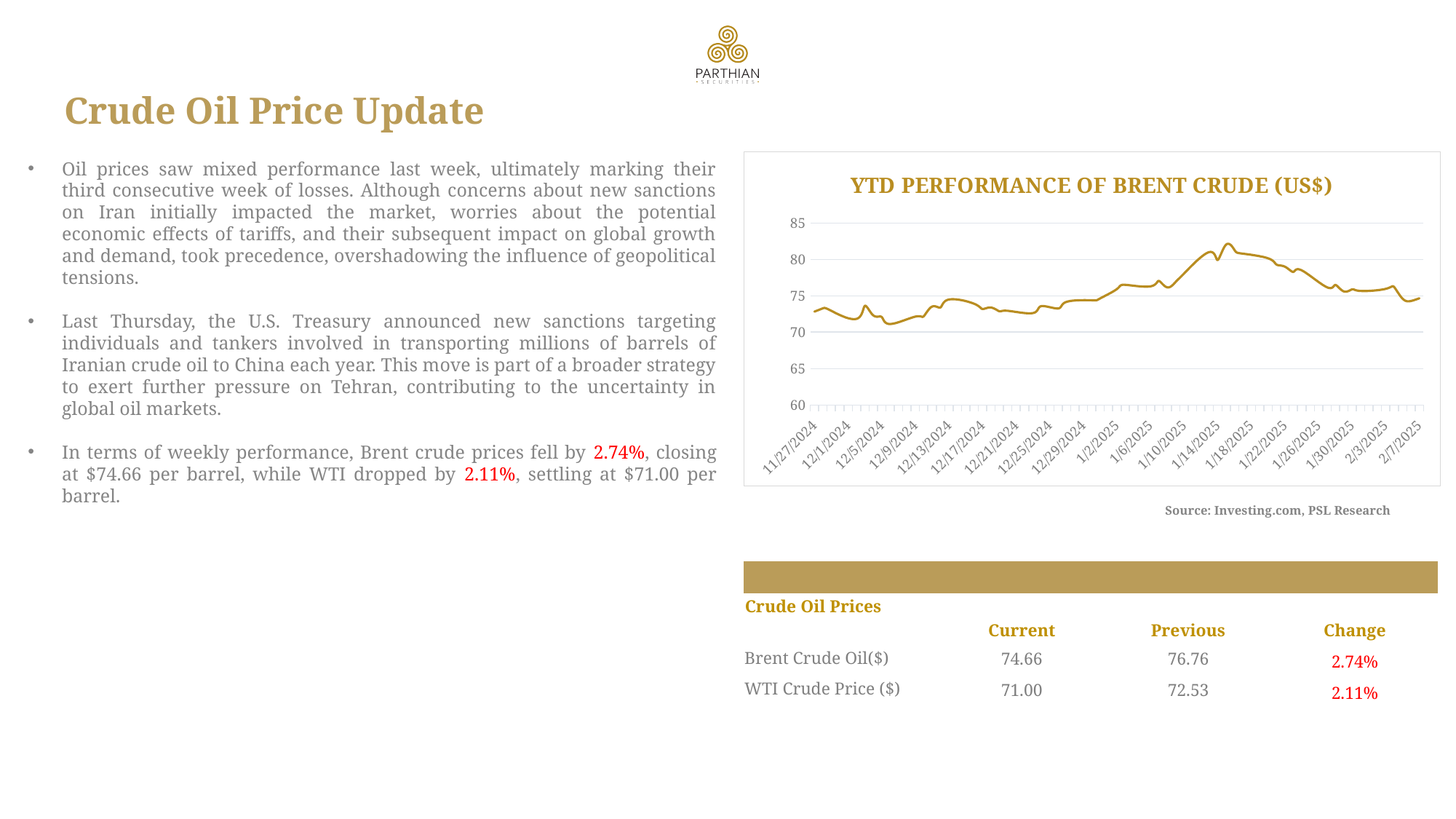
In the YTD Performance of Brent Crude chart, is the value around 1/14/2025 larger or smaller than the value at 12/5/2024? larger What is the title of the chart on the slide? YTD PERFORMANCE OF BRENT CRUDE (US$) What are the lowest and highest values shown on the y axis of the YTD Performance of Brent Crude chart? 60 and 85 In the YTD Performance of Brent Crude chart, is the value at 1/22/2025 greater or less than 75? greater What kind of chart is shown on the slide? line chart In the YTD Performance of Brent Crude chart, does the line rise or fall between 12/25/2024 and 1/14/2025? rise In the YTD Performance of Brent Crude chart, in which month does the line reach its highest point? January 2025 How many date labels are shown on the x axis of the YTD Performance of Brent Crude chart? 19 In the YTD Performance of Brent Crude chart, is the value at 12/5/2024 greater or less than 75? less In the YTD Performance of Brent Crude chart, does the line rise or fall between 1/18/2025 and 2/7/2025? fall In the YTD Performance of Brent Crude chart, is the value at 11/27/2024 greater or less than 75? less